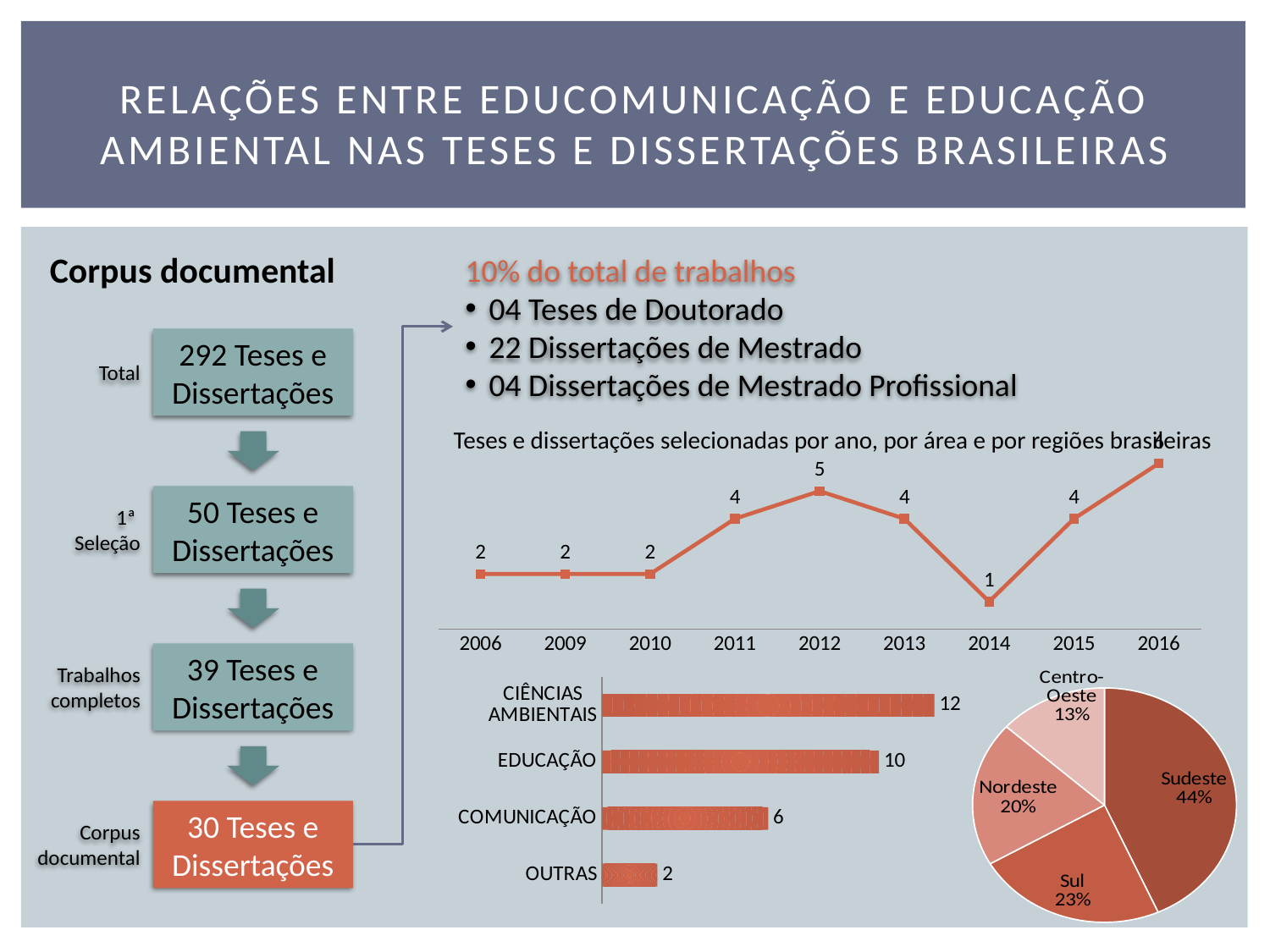
In the line chart of theses and dissertations by year, how many years are plotted on the x axis? 9 In the line chart of theses and dissertations by year, which year has the highest value? 2016 In the line chart of theses and dissertations by year, which year has the lowest value? 2014 In the line chart of theses and dissertations by year, what is the value for 2012? 5 In the line chart of theses and dissertations by year, what is the difference between the values for 2012 and 2014? 4 In the pie chart by region, which is larger, Sul or Nordeste? Sul In the horizontal bar chart by area, which category has the highest value? CIÊNCIAS AMBIENTAIS In the horizontal bar chart by area, what is the value for EDUCAÇÃO? 10 In the line chart of theses and dissertations by year, what is the value for 2014? 1 In the pie chart by region, what share does Sudeste have? 44% In the horizontal bar chart by area, what is the difference between CIÊNCIAS AMBIENTAIS and COMUNICAÇÃO? 6 What kind of chart shows the values by area (CIÊNCIAS AMBIENTAIS, EDUCAÇÃO, COMUNICAÇÃO, OUTRAS)? bar chart